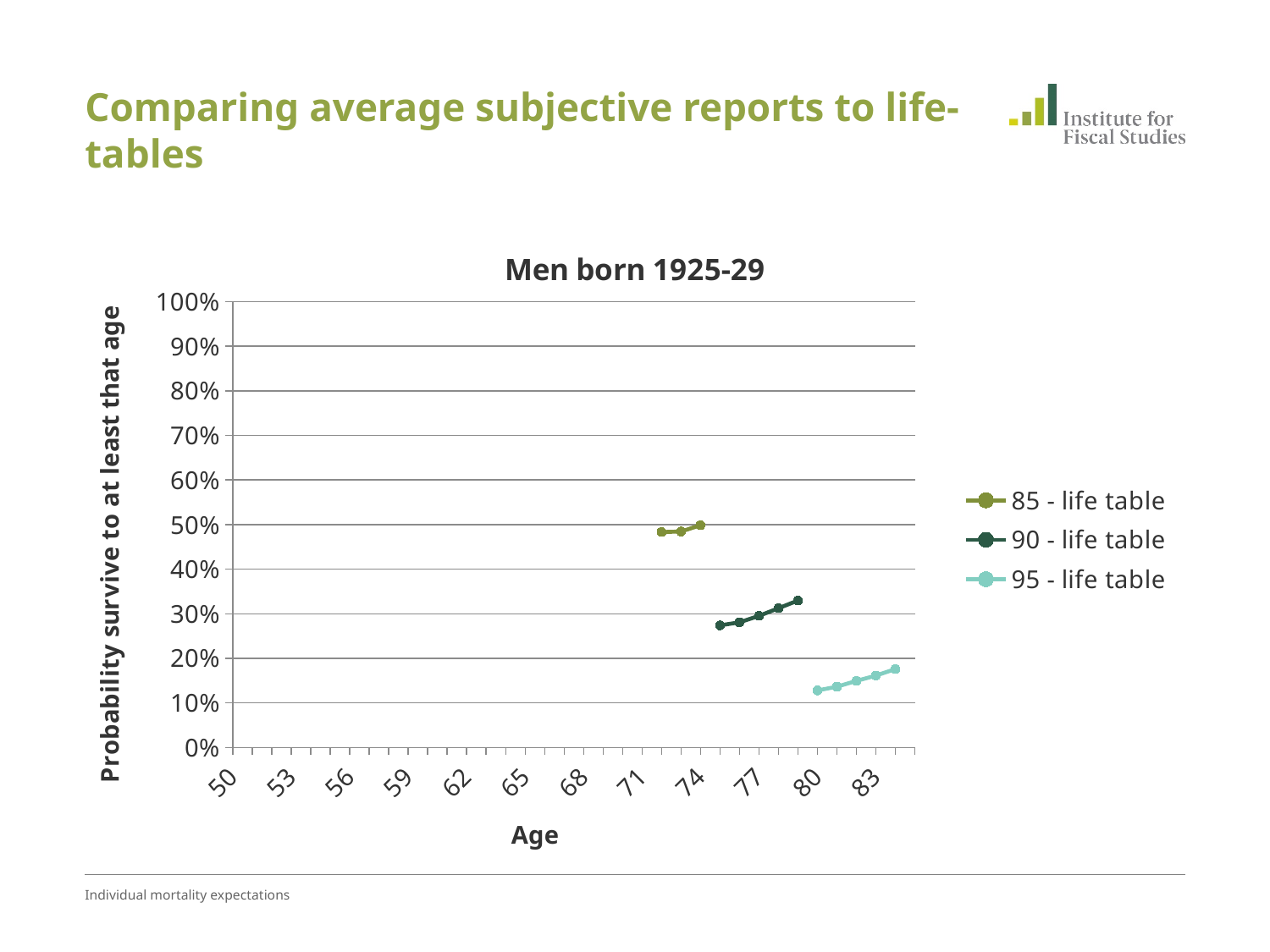
Are the values for the 95 - life table series greater or less than 20%? less What is the label of the vertical axis? Probability survive to at least that age Are the values for the 90 - life table series greater or less than 20%? greater Which series has the lowest values on the chart? 95 - life table How many series does the legend list? 3 Which series has the highest values on the chart? 85 - life table Are the values for the 90 - life table series greater or less than 40%? less Which series has larger values, 90 - life table or 95 - life table? 90 - life table What kind of chart is shown on the slide? line chart Do the values of the 95 - life table series rise or fall as age increases? rise What is the title of the chart? Men born 1925-29